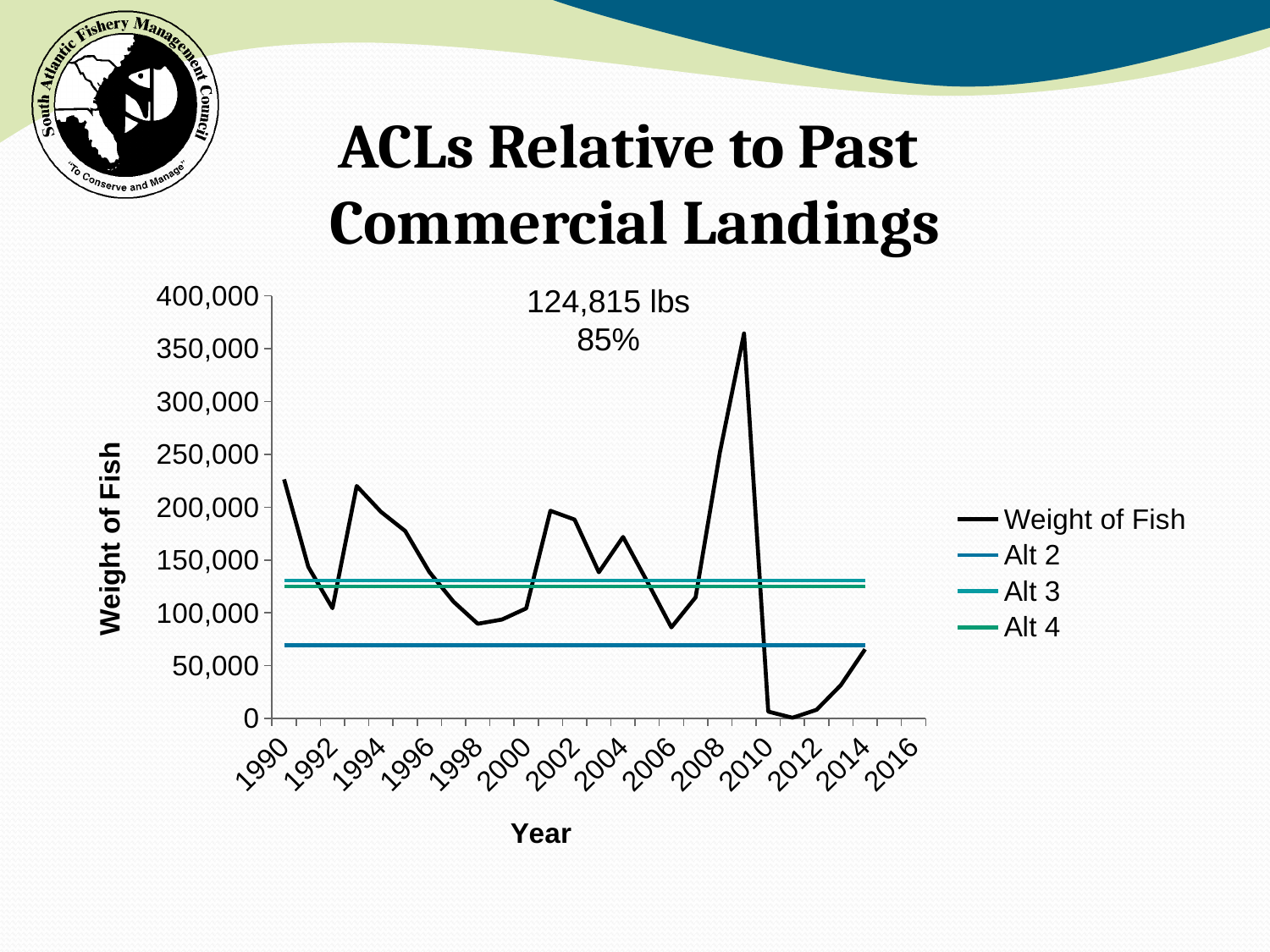
Does the Weight of Fish series rise or fall between 2009 and 2011? Fall Is the peak value of the Weight of Fish series greater or less than 350,000? greater What value in pounds is annotated at the top of the chart? 124,815 lbs In which year does the Weight of Fish series reach its highest value? 2009 What kind of chart is shown on the slide? Line chart What is the title of the chart on the slide? ACLs Relative to Past Commercial Landings How many series does the legend list? 4 Is the Weight of Fish value for 1990 greater or less than 200,000? greater Which is larger, the Weight of Fish value in 1990 or in 1992? 1990 Is the Alt 2 line greater or less than 100,000? less What percentage is annotated at the top of the chart? 85% What are the names of the series listed in the legend? Weight of Fish, Alt 2, Alt 3, Alt 4